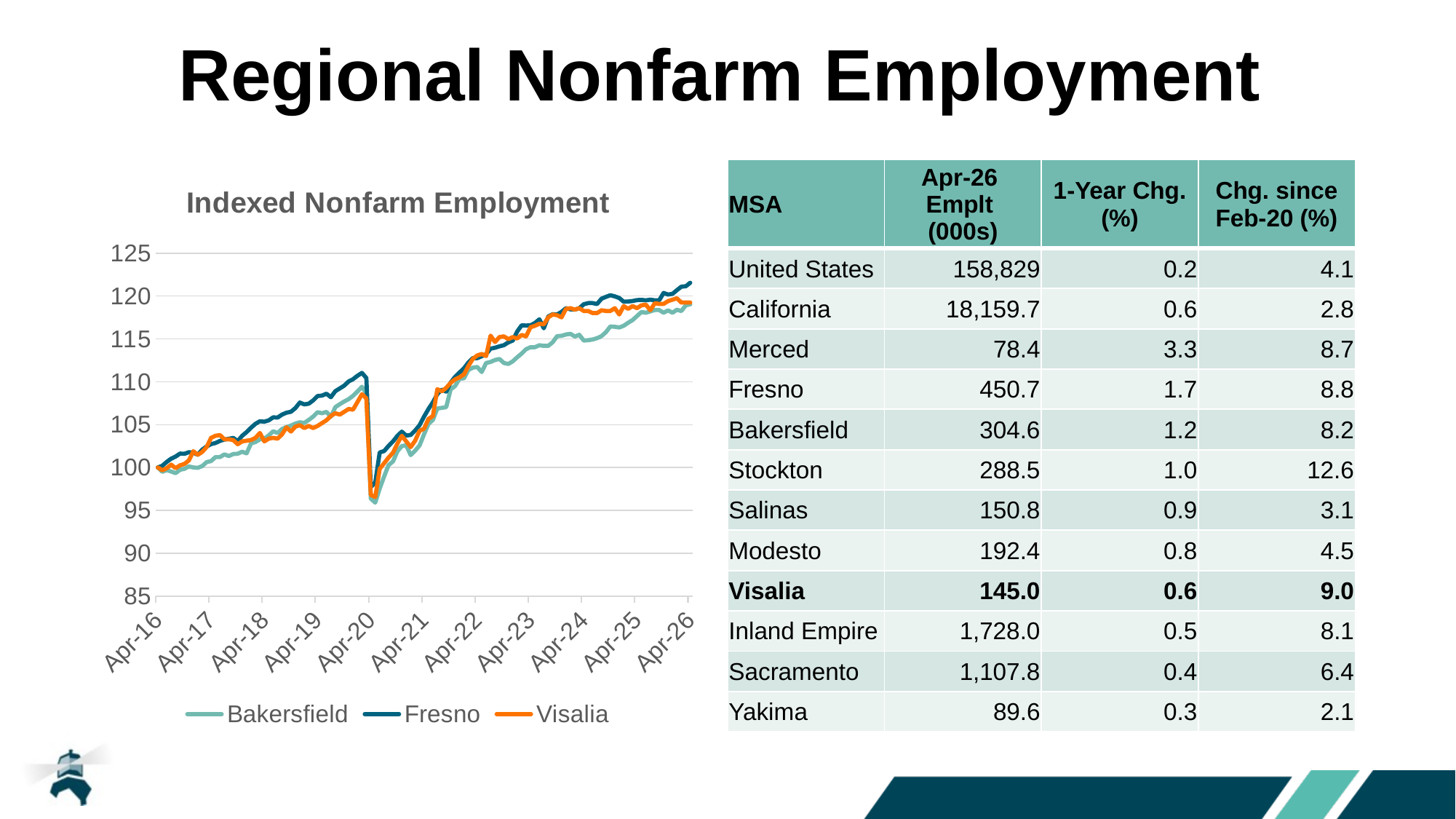
Which series is highest at Apr-26 on the Indexed Nonfarm Employment chart? Fresno Which series in the Indexed Nonfarm Employment chart is drawn in orange? Visalia Which series are shown in the legend of the Indexed Nonfarm Employment chart? Bakersfield, Fresno, Visalia Around which x-axis label does the sharp drop occur in the Indexed Nonfarm Employment chart? Apr-20 At Apr-19, which is higher on the Indexed Nonfarm Employment chart, Fresno or Visalia? Fresno Overall, do the series in the Indexed Nonfarm Employment chart rise or fall from Apr-16 to Apr-26? rise What kind of chart is the Indexed Nonfarm Employment chart? line chart How many series does the legend of the Indexed Nonfarm Employment chart list? 3 At the low point around Apr-20, is the value for Visalia greater or less than 100 on the Indexed Nonfarm Employment chart? less Is the value for Fresno at Apr-26 greater or less than 120 on the Indexed Nonfarm Employment chart? greater Is the value for Bakersfield at Apr-26 greater or less than 120 on the Indexed Nonfarm Employment chart? less At what index value do all three series start in Apr-16 on the Indexed Nonfarm Employment chart? 100